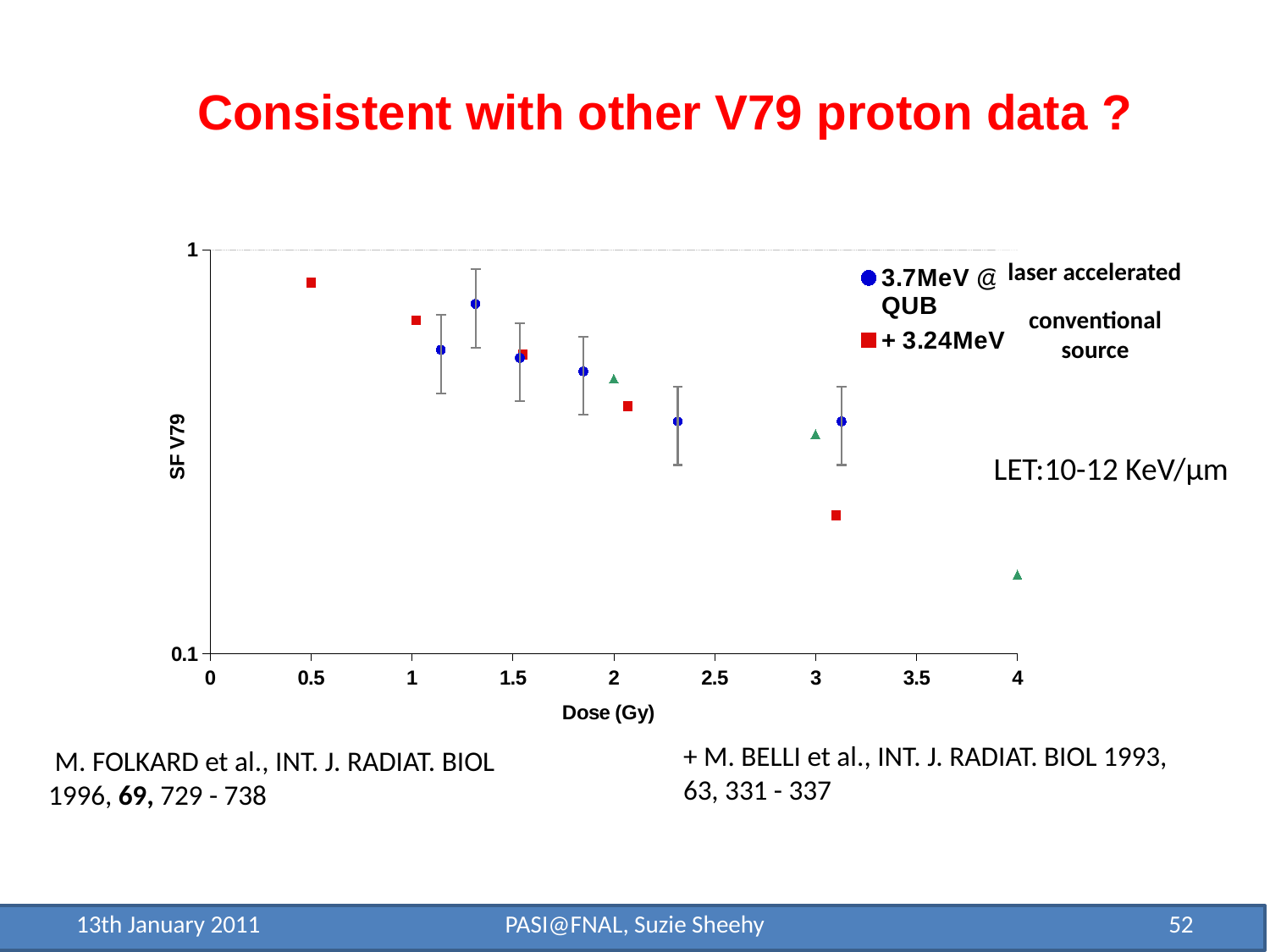
What is the label of the y axis of the chart? SF V79 How many blue circle (3.7MeV @ QUB) data points are plotted on the chart? 6 Is the SF V79 value of the red square at about 3.1 Gy greater or less than 0.1? greater What kind of chart is shown on the slide? scatter chart Is the SF V79 value of the red square at 0.5 Gy greater or less than 1? less At a dose of about 3.1 Gy, which is higher: the blue circle (3.7MeV @ QUB) point or the red square (+ 3.24MeV) point? the blue circle (3.7MeV @ QUB) How many red square (+ 3.24MeV) data points are plotted on the chart? 5 How many series does the chart legend list? 2 As dose increases along the x axis, do the SF V79 values rise or fall? fall Which legend series contains the highest plotted point on the chart? + 3.24MeV What is the label of the x axis of the chart? Dose (Gy) What is the highest dose value shown on the x axis of the chart? 4